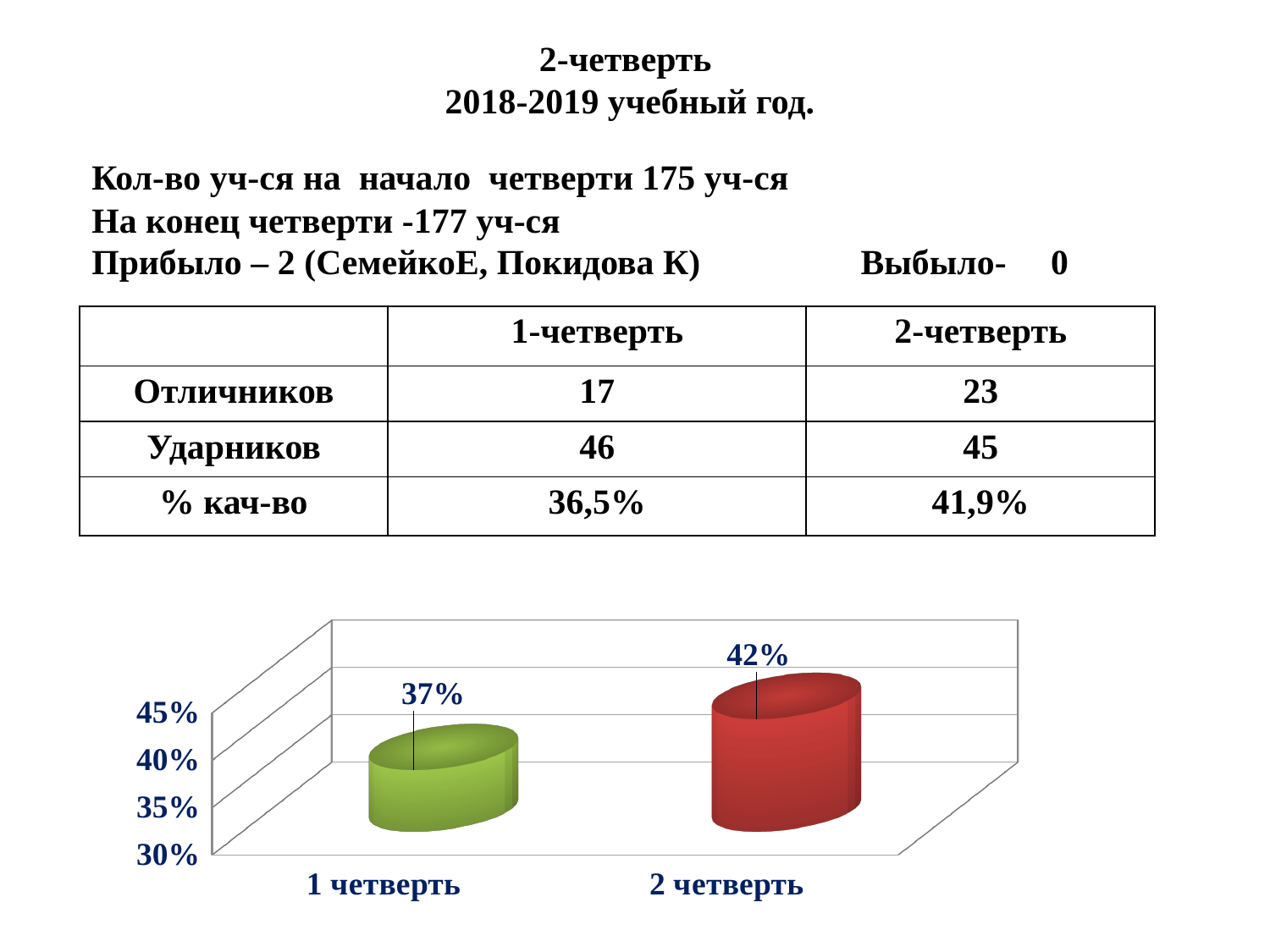
Is the value for 2 четверть greater or less than 40%? greater What is the value shown for 2 четверть on the chart? 42% Which category has the lowest value on the chart? 1 четверть What is the difference between the values for 2 четверть and 1 четверть on the chart? 5% Do the values rise or fall from 1 четверть to 2 четверть? rise What is the value shown for 1 четверть on the chart? 37% Which category has the highest value on the chart? 2 четверть What colour is the bar for 2 четверть? red Which is larger on the chart, the value for 1 четверть or for 2 четверть? 2 четверть Is the value for 1 четверть greater or less than 40%? less How many categories are plotted on the chart? 2 What kind of chart is shown on the slide? bar chart